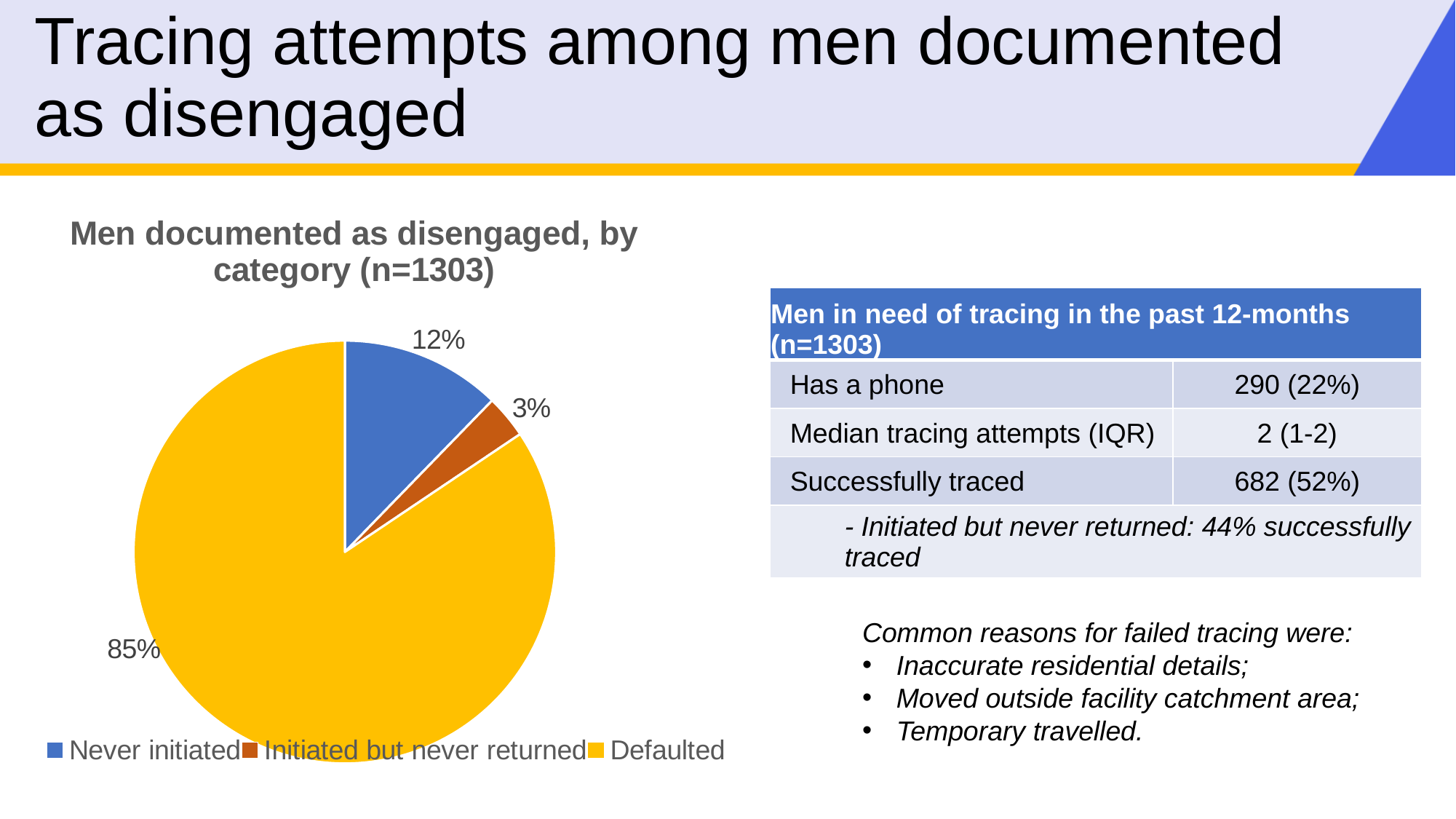
Which slice is larger, Never initiated or Initiated but never returned? Never initiated Which category has the smallest slice of the pie? Initiated but never returned What kind of chart is shown on the slide? Pie chart Which category has the largest slice of the pie? Defaulted What is the difference in percentage points between the Defaulted slice and the Never initiated slice? 73 How many categories does the pie chart show? 3 What share of the pie is labelled Never initiated? 12% What share of the pie is labelled Defaulted? 85% What colour is the Defaulted slice in the pie chart? Yellow What is the combined share of the Never initiated and Initiated but never returned slices? 15% What share of the pie is labelled Initiated but never returned? 3% What is the title of the pie chart? Men documented as disengaged, by category (n=1303)